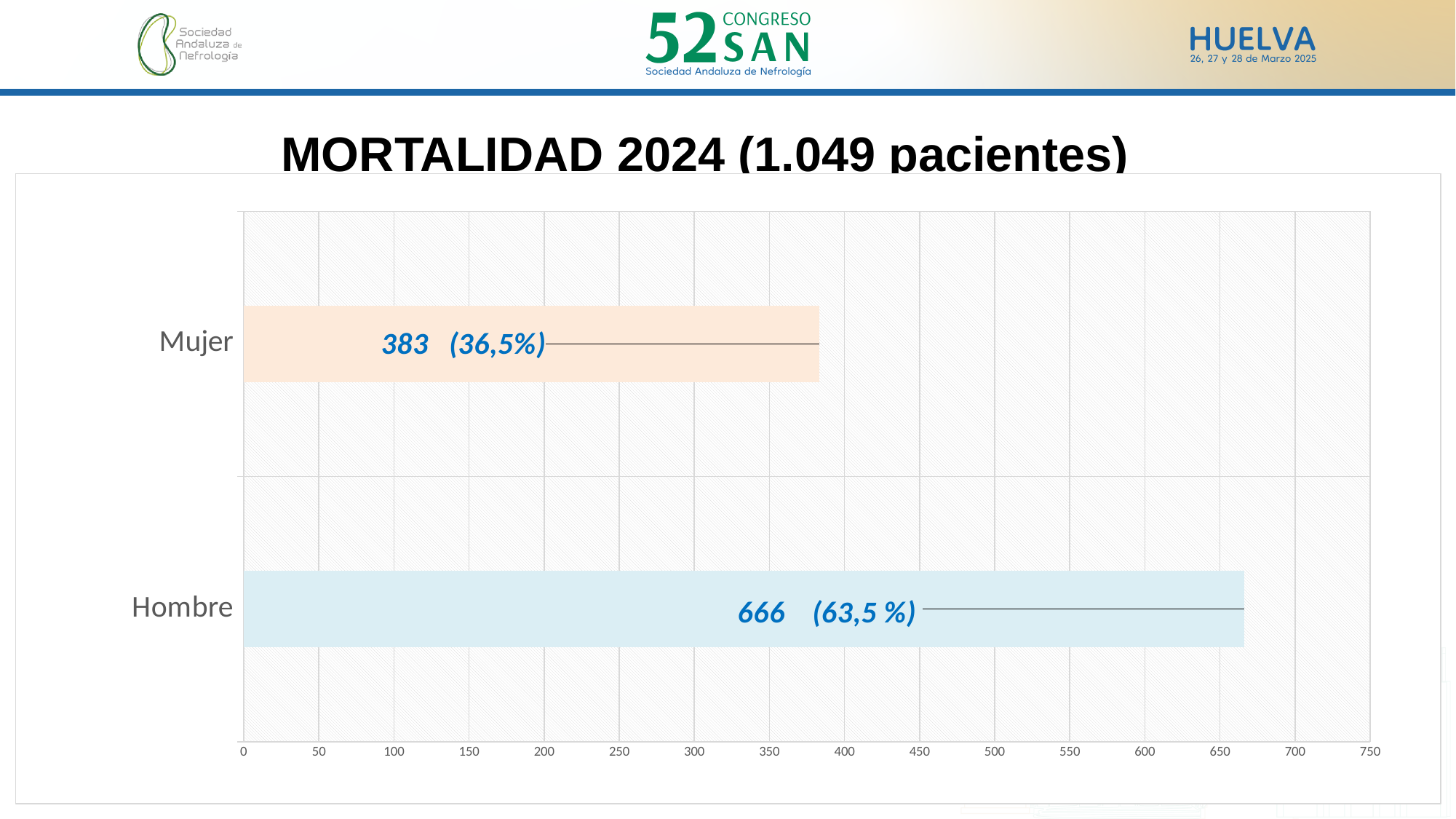
How many categories are shown in the chart? 2 Which is larger, the value for Mujer or the value for Hombre? Hombre Is the value for Mujer greater or less than 400? less Which category has the highest value? Hombre What percentage is shown for Mujer? 36,5% What percentage is shown for Hombre? 63,5 % What is the value for Mujer? 383 What is the value for Hombre? 666 What is the difference between the values for Hombre and Mujer? 283 What kind of chart is shown on the slide? bar chart What is the title of the chart? MORTALIDAD 2024 (1.049 pacientes) Which category has the lowest value? Mujer